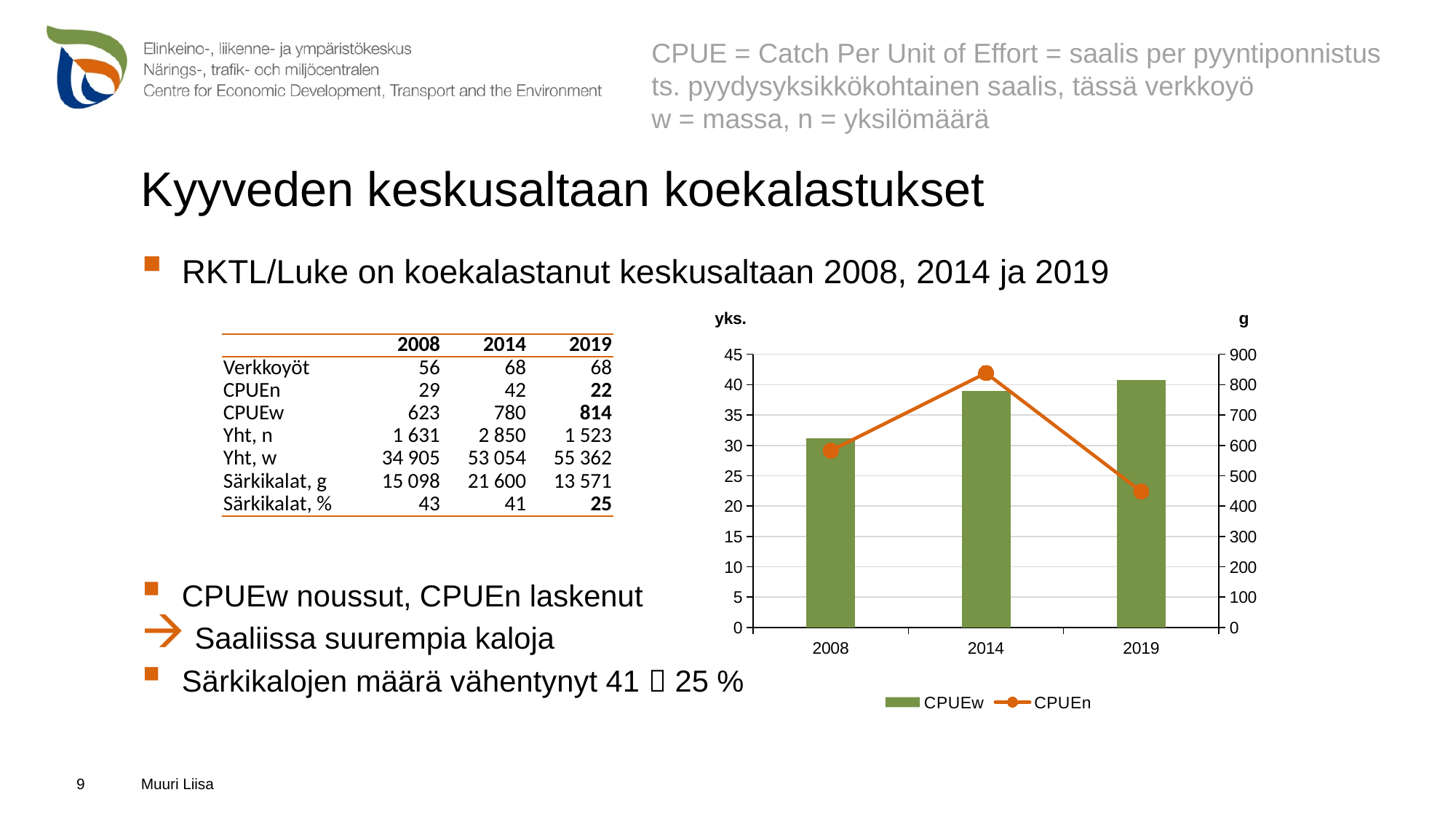
In which year is the CPUEw bar lowest? 2008 In which year is the CPUEn value highest? 2014 Which year has the larger CPUEn value, 2008 or 2019? 2008 Is the CPUEn value for 2019 greater or less than 25 on the left axis? less How many series does the chart legend list? 2 Do the CPUEw bars rise or fall from 2008 to 2019? rise What kind of chart is used to show the CPUEw series? bar chart What kind of chart is used to show the CPUEn series? line chart In which year is the CPUEw bar highest? 2019 Is the CPUEw value for 2008 greater or less than 700 on the right axis? less How many years are shown on the x axis of the chart? 3 In which year is the CPUEn value lowest? 2019